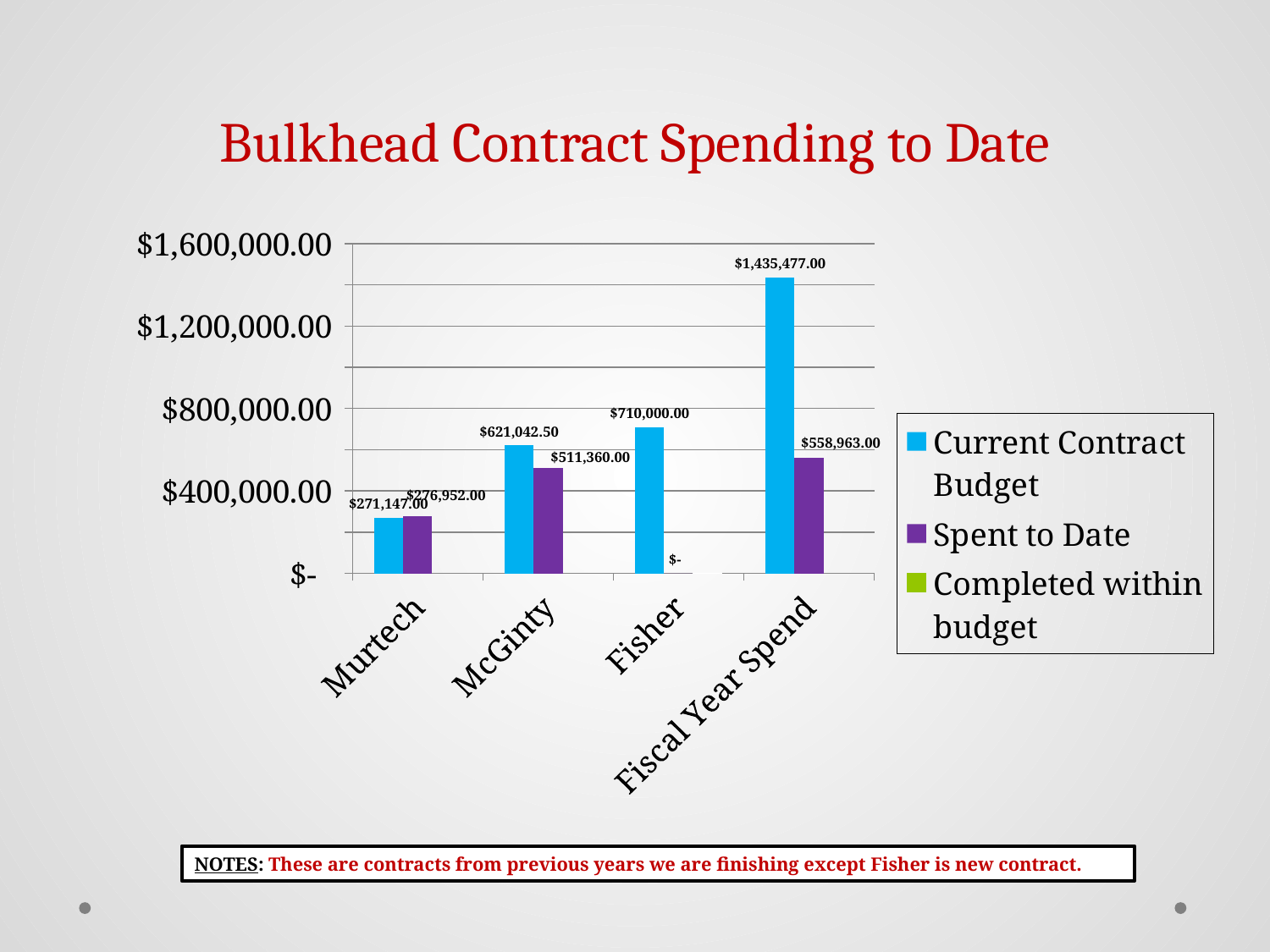
What kind of chart is shown on the slide? Bar chart How many categories are shown on the x axis? 4 Which category has the highest Current Contract Budget? Fiscal Year Spend For Murtech, which is larger: the Current Contract Budget or Spent to Date? Spent to Date Which category has the lowest Current Contract Budget? Murtech What is the Current Contract Budget value for Murtech? $271,147.00 What is the difference between the Current Contract Budget and Spent to Date for McGinty? $109,682.50 How many series does the legend list? 3 What is the Spent to Date value for Fisher? $- What is the Current Contract Budget value for McGinty? $621,042.50 What is the Spent to Date value for Fiscal Year Spend? $558,963.00 What is the difference between the Current Contract Budget and Spent to Date for Fiscal Year Spend? $876,514.00